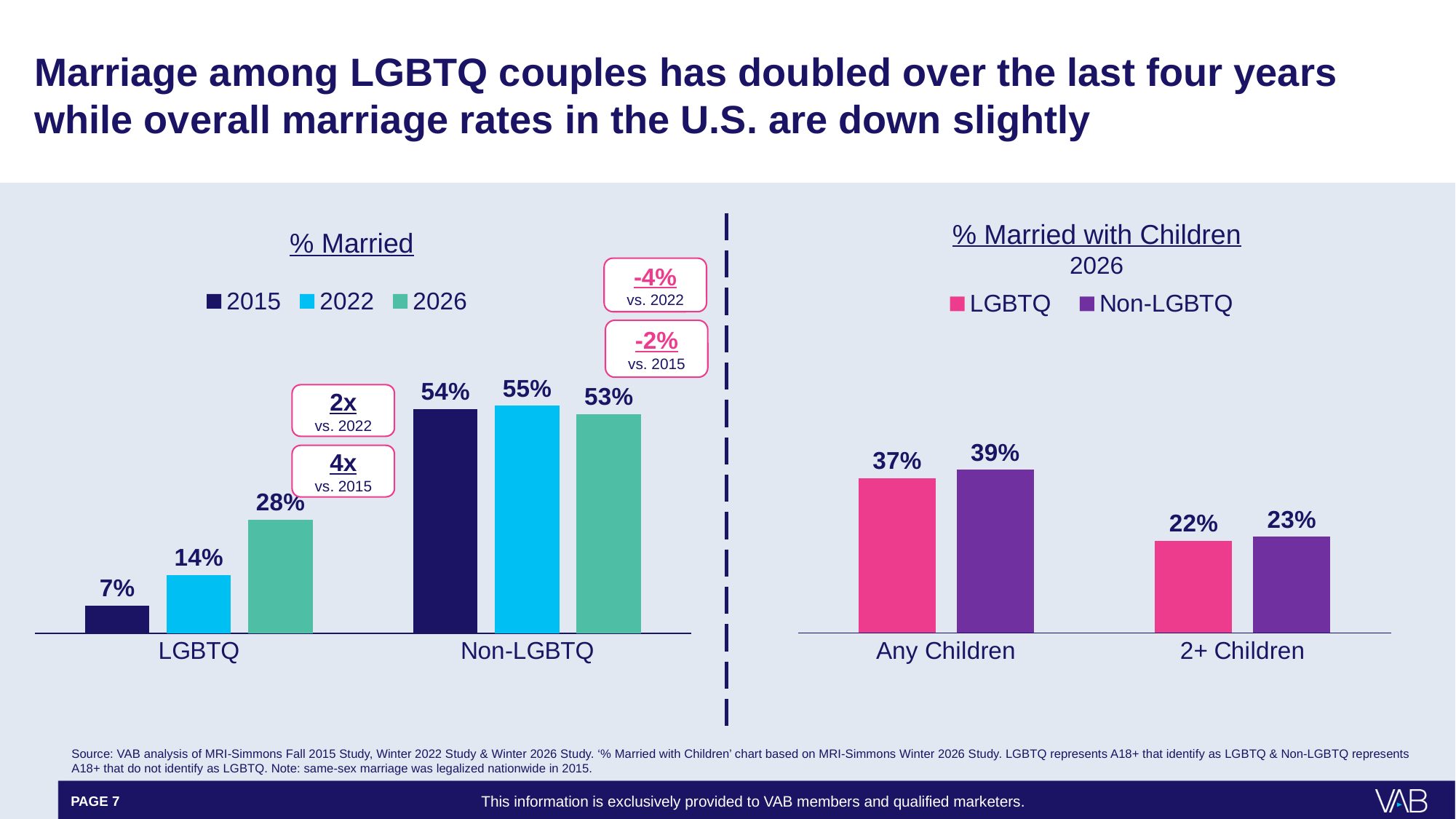
In the '% Married' chart, what is the value for LGBTQ in 2015? 7% In the '% Married' chart, what is the difference between the Non-LGBTQ and LGBTQ values for 2026? 25% In the '% Married with Children' chart, what is the difference between Non-LGBTQ and LGBTQ for Any Children? 2% In the '% Married' chart, what is the value for LGBTQ in 2026? 28% In the '% Married' chart, what is the value for Non-LGBTQ in 2022? 55% In the '% Married' chart, how many series does the legend list? 3 In the '% Married with Children' chart, what is the value for Non-LGBTQ with 2+ Children? 23% In the '% Married' chart, which year has the highest value for Non-LGBTQ? 2022 What kind of chart is the '% Married with Children' chart? bar chart In the '% Married with Children' chart, what is the value for LGBTQ with Any Children? 37% In the '% Married with Children' chart, how many categories are shown on the x axis? 2 In the '% Married' chart, do the LGBTQ values rise or fall from 2015 to 2026? rise